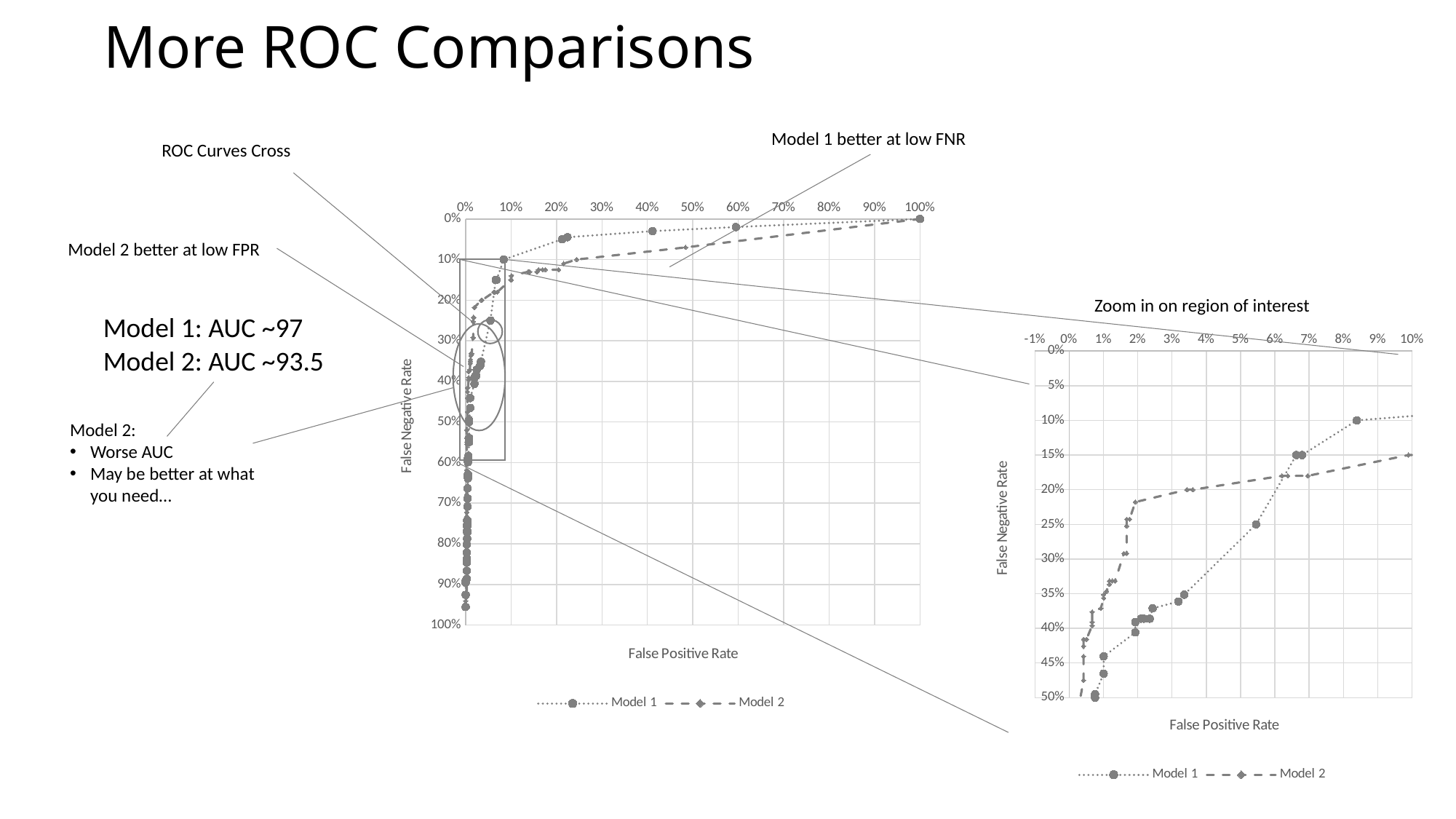
In the main ROC chart, is the False Negative Rate for Model 2 at a False Positive Rate of 60% greater or less than 10%? less In the 'Zoom in on region of interest' chart, is the False Negative Rate for Model 2 at a False Positive Rate of 2% greater or less than 25%? less In the main ROC chart, is the False Negative Rate for Model 1 at a False Positive Rate of 40% greater or less than 10%? less How many series does the legend of the main ROC chart list? 2 What kind of chart is the main ROC chart on the slide? Line chart What are the series names in the legend of the 'Zoom in on region of interest' chart? Model 1 and Model 2 In the 'Zoom in on region of interest' chart, which model has the lower False Negative Rate at a False Positive Rate of 2%? Model 2 In the main ROC chart, as the False Positive Rate increases, does the False Negative Rate rise or fall? Fall What is the x-axis label of the main ROC chart? False Positive Rate In the 'Zoom in on region of interest' chart, which model has the lower False Negative Rate at a False Positive Rate of 8%? Model 1 How many charts are shown on the slide? 2